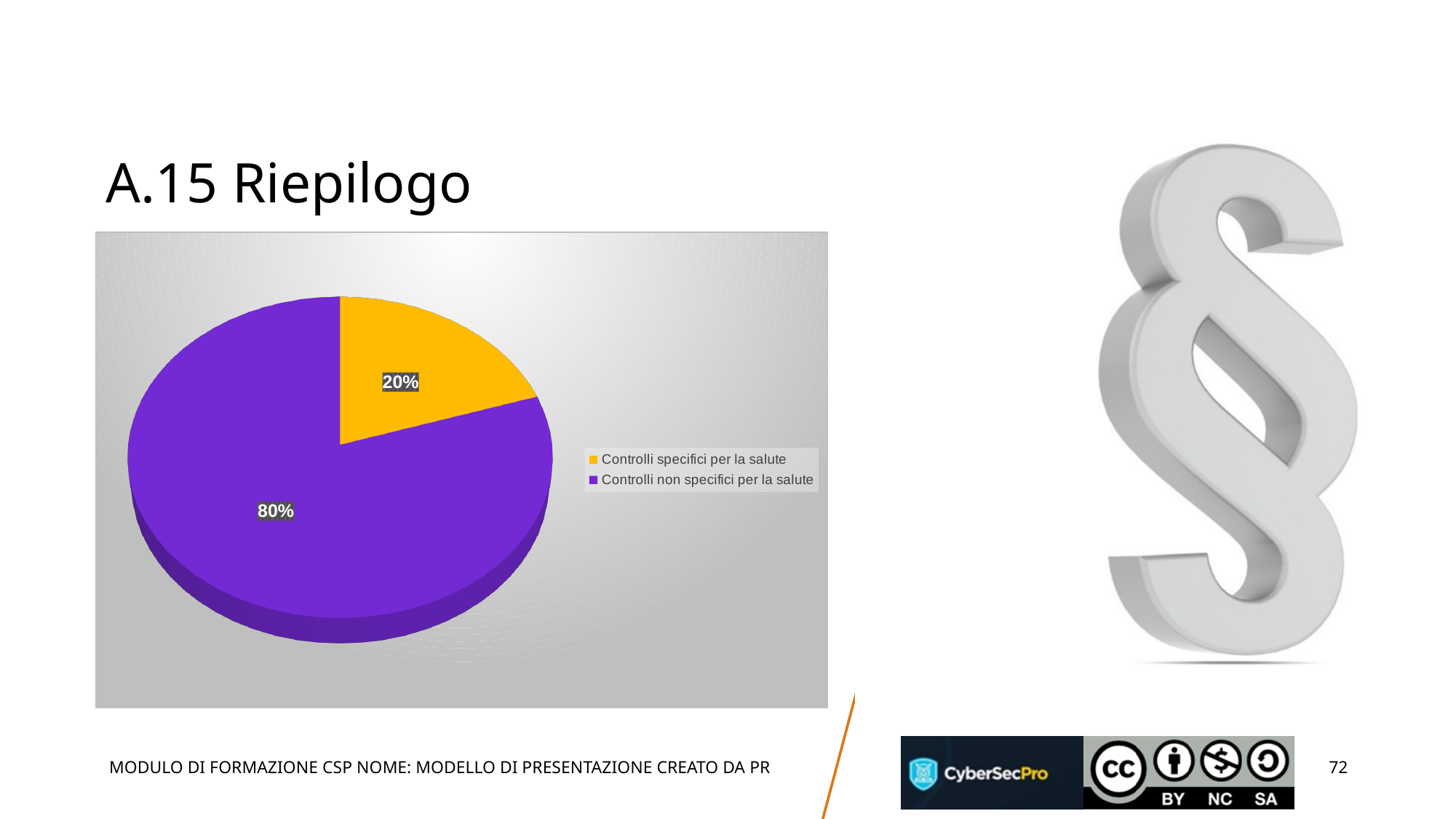
What share of the pie is labelled "Controlli specifici per la salute"? 20% What colour is the "Controlli non specifici per la salute" slice? Purple What is the difference in percentage points between the "Controlli non specifici per la salute" slice and the "Controlli specifici per la salute" slice? 60 percentage points How many slices does the pie chart have? 2 What kind of chart is shown on the slide? Pie chart What colour is the "Controlli specifici per la salute" slice? Yellow/orange Which slice of the pie is the largest? Controlli non specifici per la salute Which is larger: the "Controlli specifici per la salute" slice or the "Controlli non specifici per la salute" slice? Controlli non specifici per la salute How many entries does the legend list? 2 What share of the pie is labelled "Controlli non specifici per la salute"? 80% Which slice of the pie is the smallest? Controlli specifici per la salute